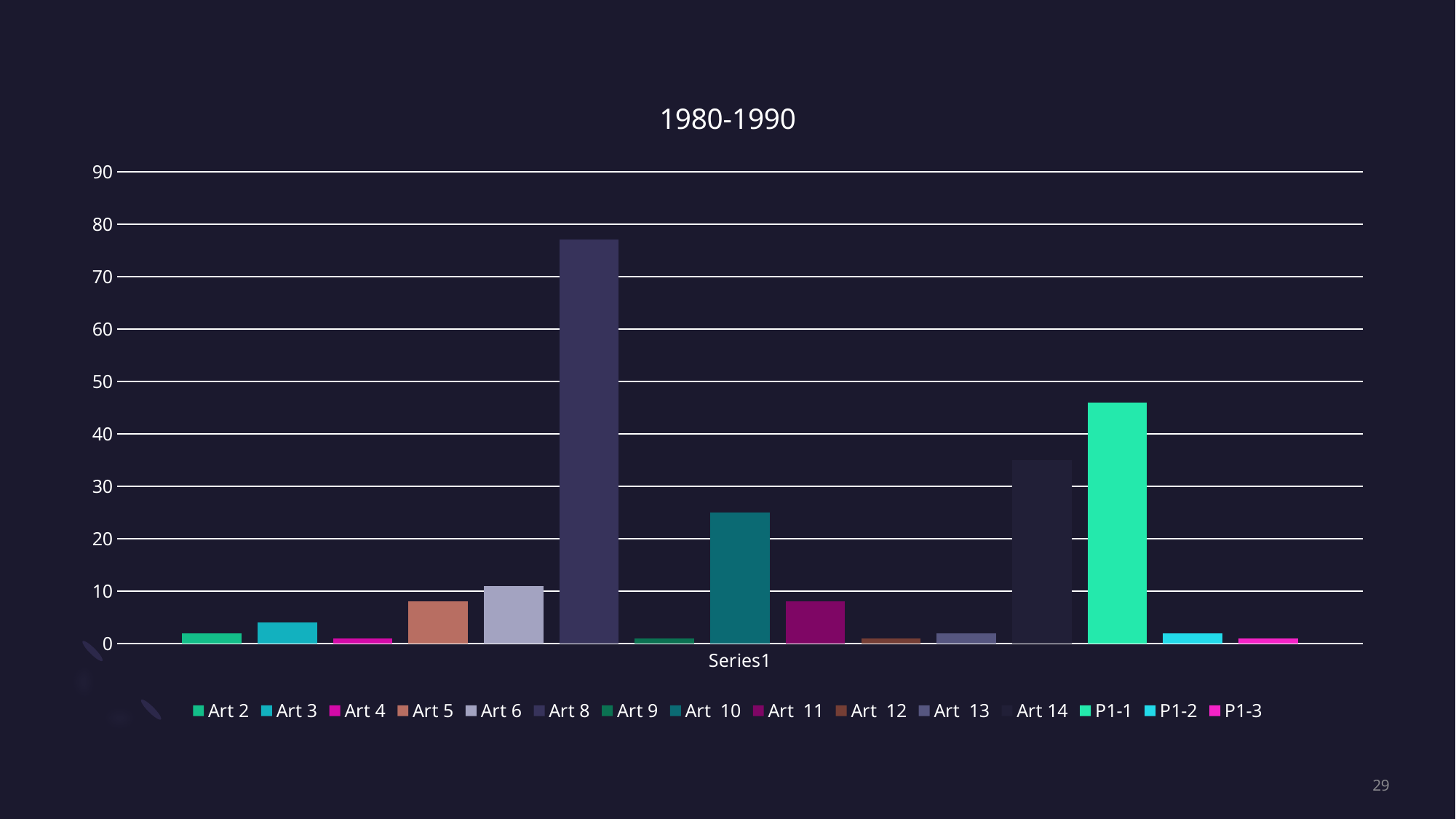
How many entries does the chart's legend list? 15 What kind of chart is shown on the slide? bar chart What is the title of the chart? 1980-1990 Is the value for Art 8 greater or less than 70? greater Is the value for Art 5 greater or less than 10? less Is the value for P1-1 greater or less than 40? greater Which is larger, the value for Art 10 or the value for Art 6? Art 10 Which is larger, the value for Art 8 or the value for P1-1? Art 8 Which series has the highest bar in the chart? Art 8 What label appears on the horizontal axis beneath the bars? Series1